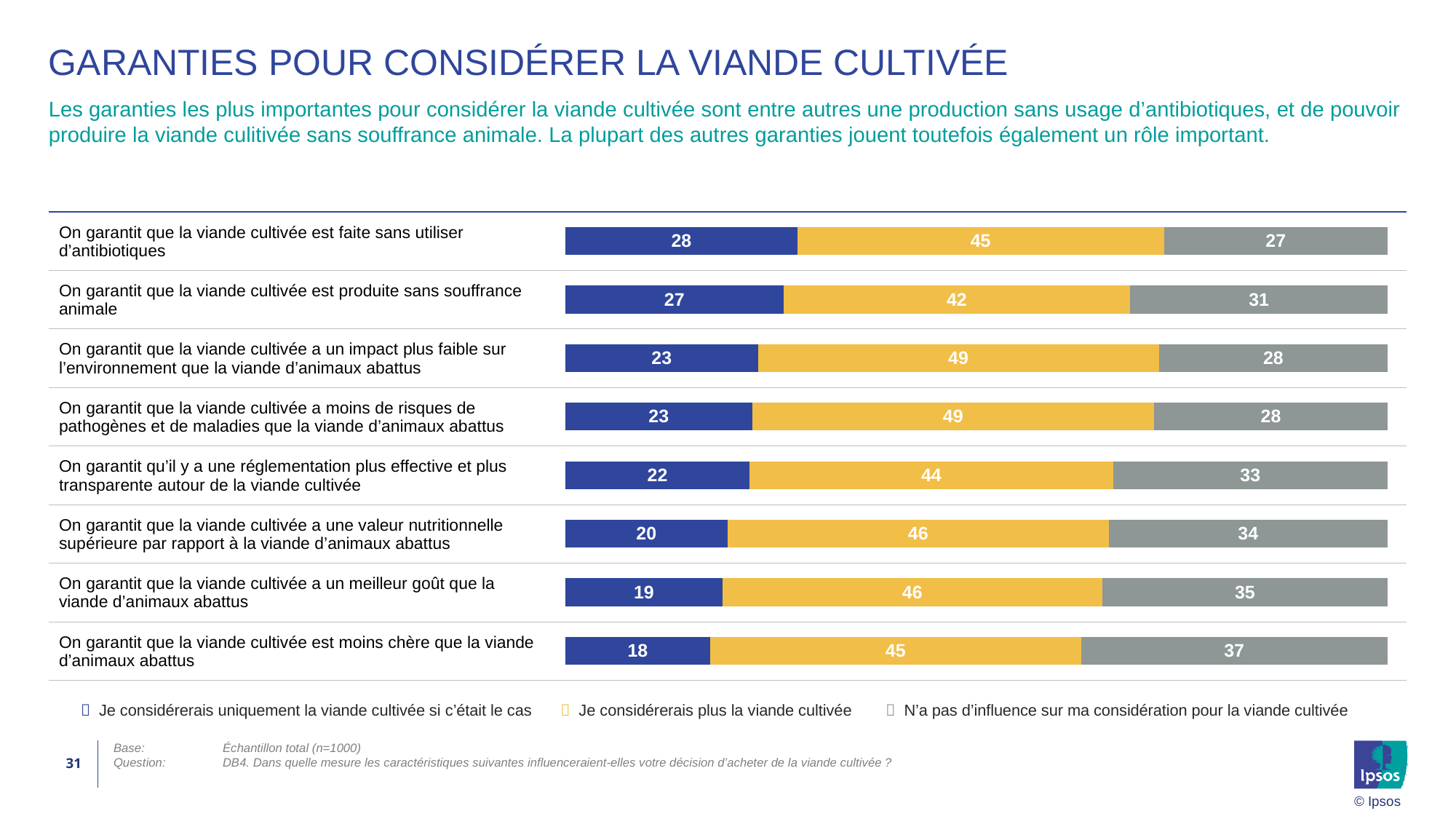
What is the value of "N'a pas d'influence sur ma considération pour la viande cultivée" for "On garantit que la viande cultivée est moins chère que la viande d'animaux abattus"? 37 Which is larger: the "Je considérerais plus la viande cultivée" value for "On garantit que la viande cultivée a un impact plus faible sur l'environnement que la viande d'animaux abattus" or for "On garantit qu'il y a une réglementation plus effective et plus transparente autour de la viande cultivée"? On garantit que la viande cultivée a un impact plus faible sur l'environnement que la viande d'animaux abattus Which category has the highest value for "N'a pas d'influence sur ma considération pour la viande cultivée"? On garantit que la viande cultivée est moins chère que la viande d'animaux abattus How many series does the legend list? 3 What is the difference between the "Je considérerais uniquement la viande cultivée si c'était le cas" values for "On garantit que la viande cultivée est faite sans utiliser d'antibiotiques" and "On garantit que la viande cultivée est moins chère que la viande d'animaux abattus"? 10 What kind of chart is shown on the slide? Stacked bar chart What is the value of "Je considérerais plus la viande cultivée" for "On garantit que la viande cultivée est produite sans souffrance animale"? 42 Which category has the lowest value for "Je considérerais uniquement la viande cultivée si c'était le cas"? On garantit que la viande cultivée est moins chère que la viande d'animaux abattus What is the value of "Je considérerais uniquement la viande cultivée si c'était le cas" for "On garantit que la viande cultivée est faite sans utiliser d'antibiotiques"? 28 What is the total of the stacked bar for "On garantit qu'il y a une réglementation plus effective et plus transparente autour de la viande cultivée"? 99 Which category has the highest value for "Je considérerais uniquement la viande cultivée si c'était le cas"? On garantit que la viande cultivée est faite sans utiliser d'antibiotiques How many categories (guarantees) are shown in the chart? 8